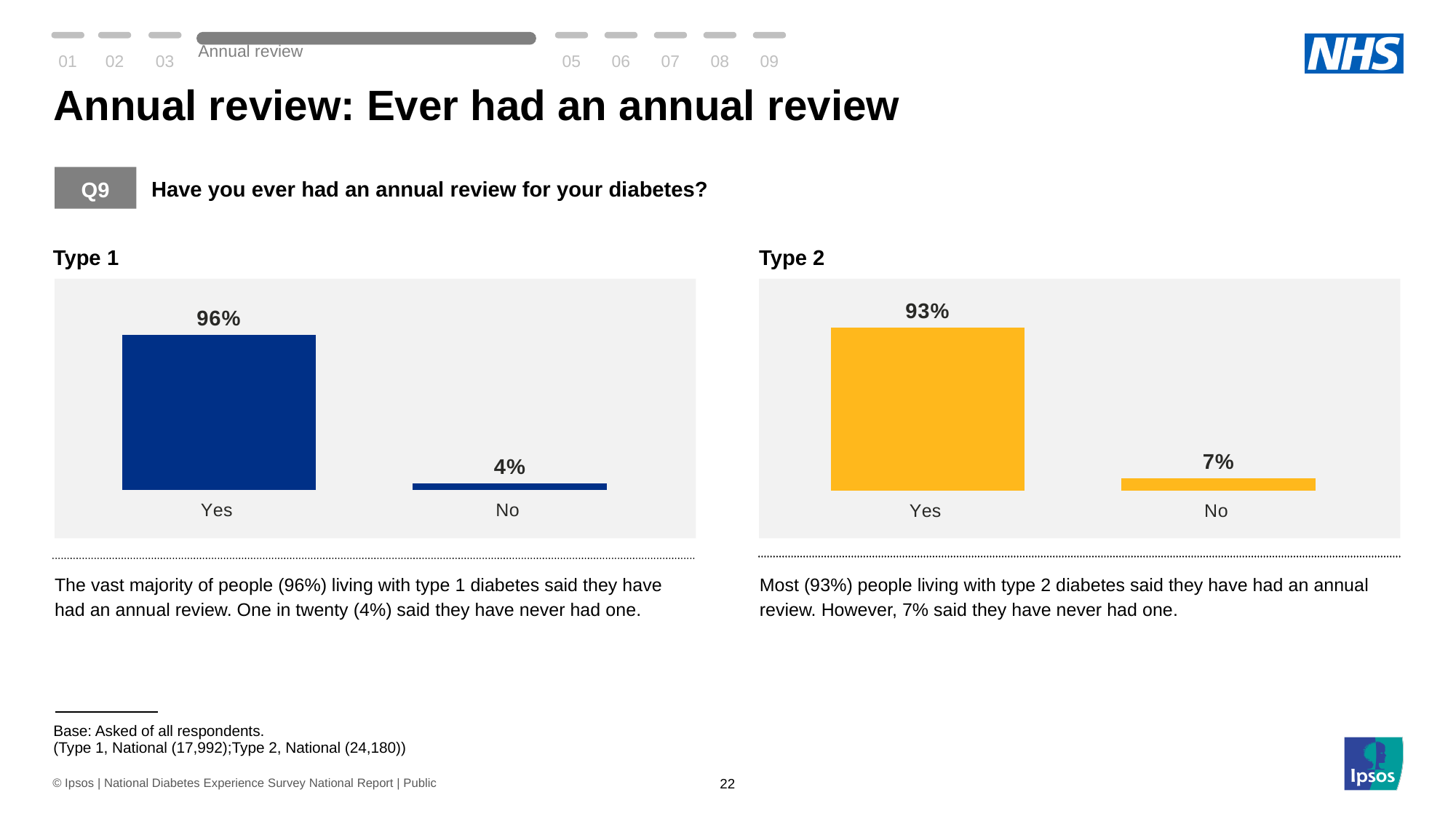
In the Type 2 chart, what percentage of respondents answered No? 7% In the Type 1 chart, what percentage of respondents answered No? 4% What kind of chart is the Type 1 chart? Bar chart In the Type 1 chart, what percentage of respondents answered Yes? 96% In the Type 2 chart, which category has the highest value? Yes How many categories are shown in the Type 2 chart? 2 Which is larger: the Yes value in the Type 1 chart or the Yes value in the Type 2 chart? Type 1 In the Type 2 chart, what percentage of respondents answered Yes? 93% In the Type 1 chart, what is the difference between the Yes and No values? 92% In the Type 2 chart, what is the difference between the Yes and No values? 86% In the Type 1 chart, which category has the lowest value? No What colour are the bars in the Type 2 chart? Yellow